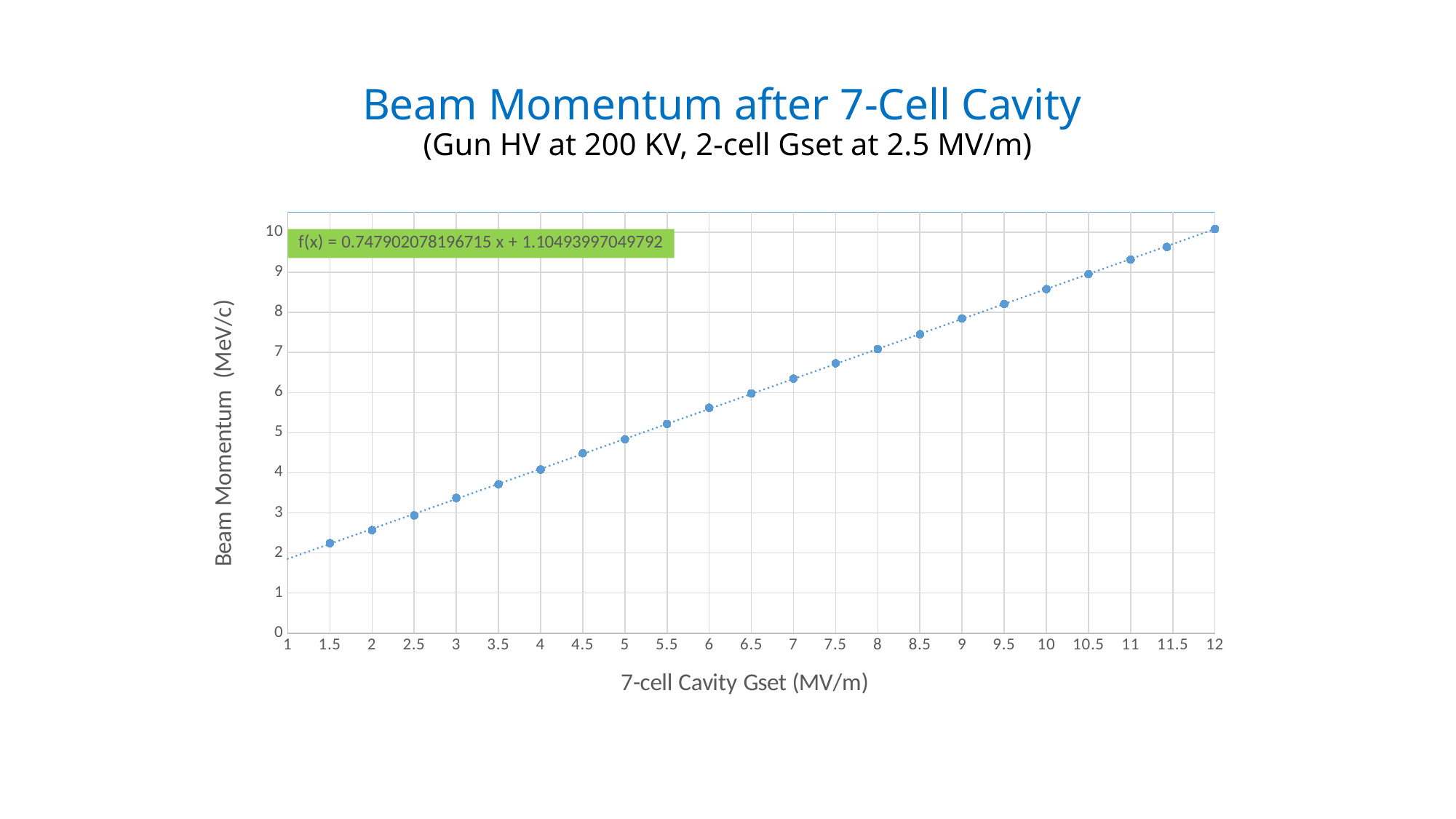
Does the beam momentum rise or fall as the 7-cell cavity Gset increases? Rises What is the title of the chart? Beam Momentum after 7-Cell Cavity What is the label of the x axis? 7-cell Cavity Gset (MV/m) Is the beam momentum at a Gset of 2 MV/m greater or less than 3 MeV/c? less At which 7-cell Cavity Gset value is the beam momentum lowest? 1.5 Is the beam momentum at a Gset of 10 MV/m greater or less than 8 MeV/c? greater Which has the larger beam momentum: a Gset of 5 MV/m or a Gset of 9 MV/m? 9 MV/m Is the beam momentum at a Gset of 6 MV/m greater or less than 5 MeV/c? greater How many data points are plotted on the chart? 22 At which 7-cell Cavity Gset value is the beam momentum highest? 12 What kind of chart is shown on the slide? Scatter chart